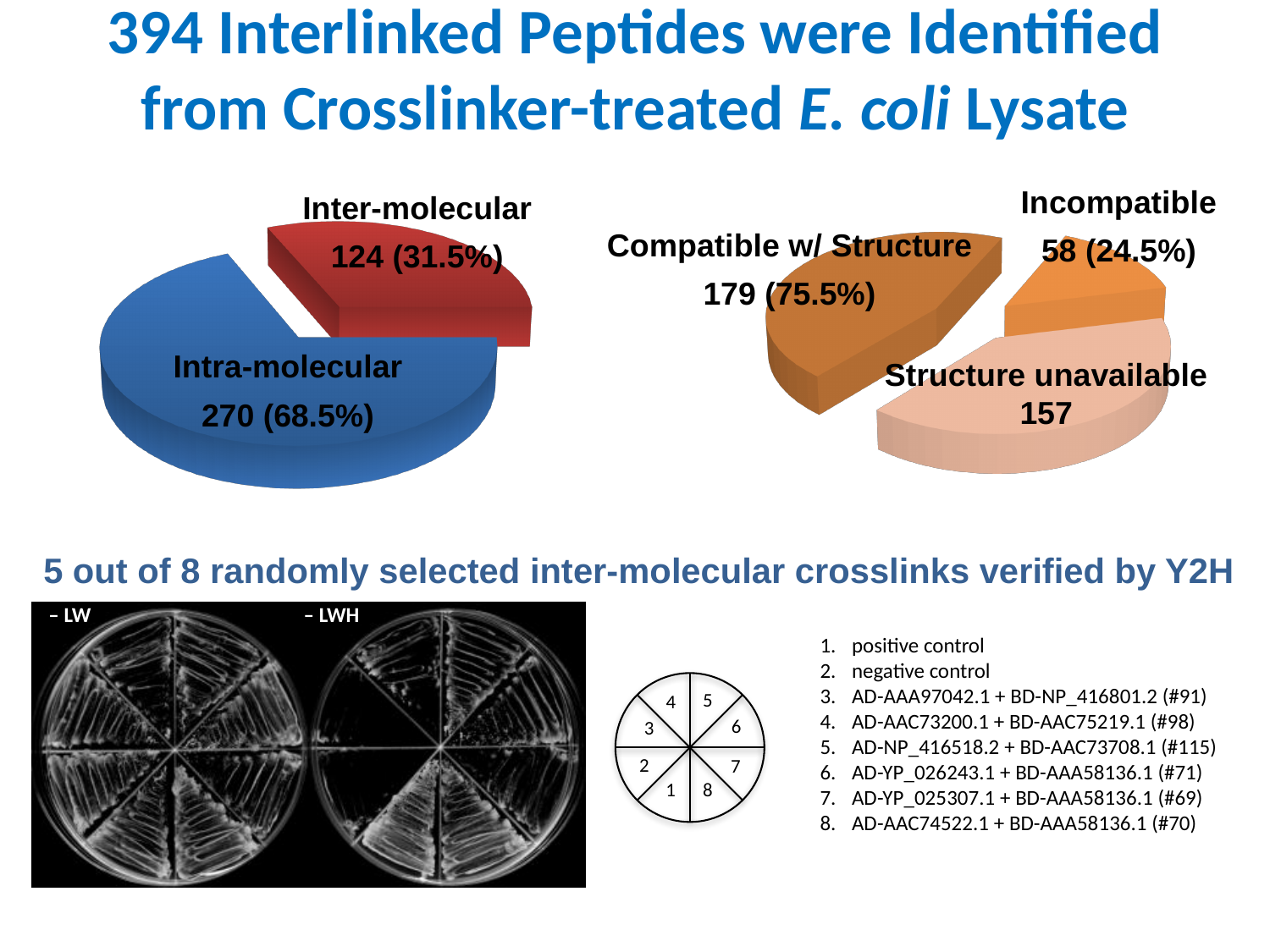
In the left pie chart, what is the difference between the intra-molecular and inter-molecular counts? 146 In the left pie chart, what percentage of interlinked peptides are inter-molecular? 31.5% In the right pie chart, how many crosslinks are compatible with structure? 179 What kind of chart is used on the left side of the slide? Pie chart In the right pie chart, what is the difference between the Compatible w/ Structure count and the Incompatible count? 121 In the right pie chart, how many crosslinks have structure unavailable? 157 In the right pie chart, what percentage is labelled as incompatible? 24.5% In the right pie chart, which category is the smallest? Incompatible In the right pie chart, which is larger: Compatible w/ Structure or Structure unavailable? Compatible w/ Structure In the left pie chart, which category is the largest? Intra-molecular In the left pie chart, how many interlinked peptides are intra-molecular? 270 In the left pie chart, how many slices are there? 2